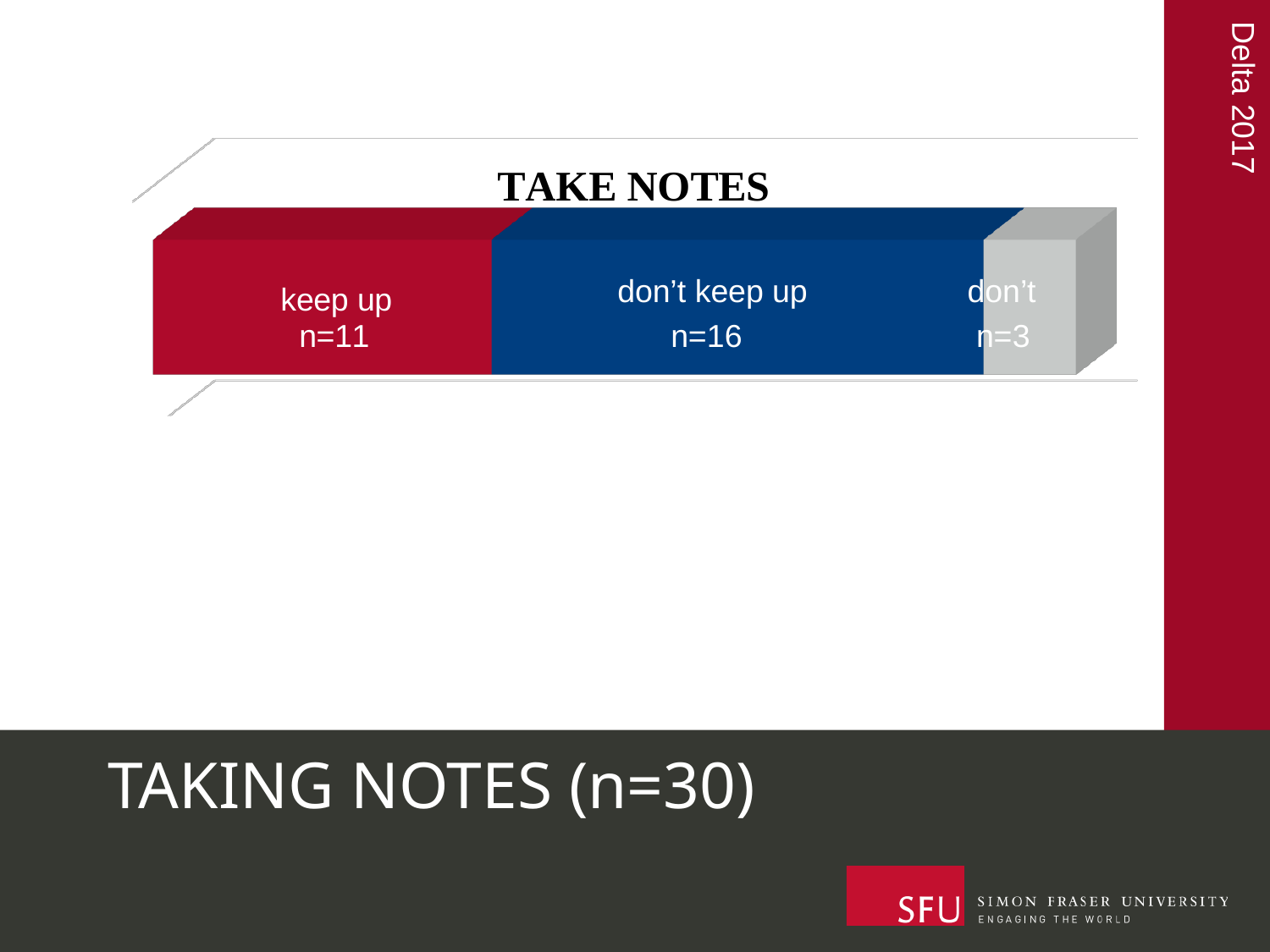
What is the value for the "keep up" segment? n=11 What is the value for the "don't" segment? n=3 What colour is the "keep up" segment? red How many segments does the stacked bar have? 3 Which segment has the largest value? don't keep up What is the title of the chart? TAKE NOTES What is the value for the "don't keep up" segment? n=16 Which segment has the smallest value? don't What is the total of all segments in the stacked bar? 30 What is the difference between the "don't keep up" and "keep up" values? 5 What kind of chart is shown on the slide? bar chart Which is larger, the value for "keep up" or the value for "don't"? keep up